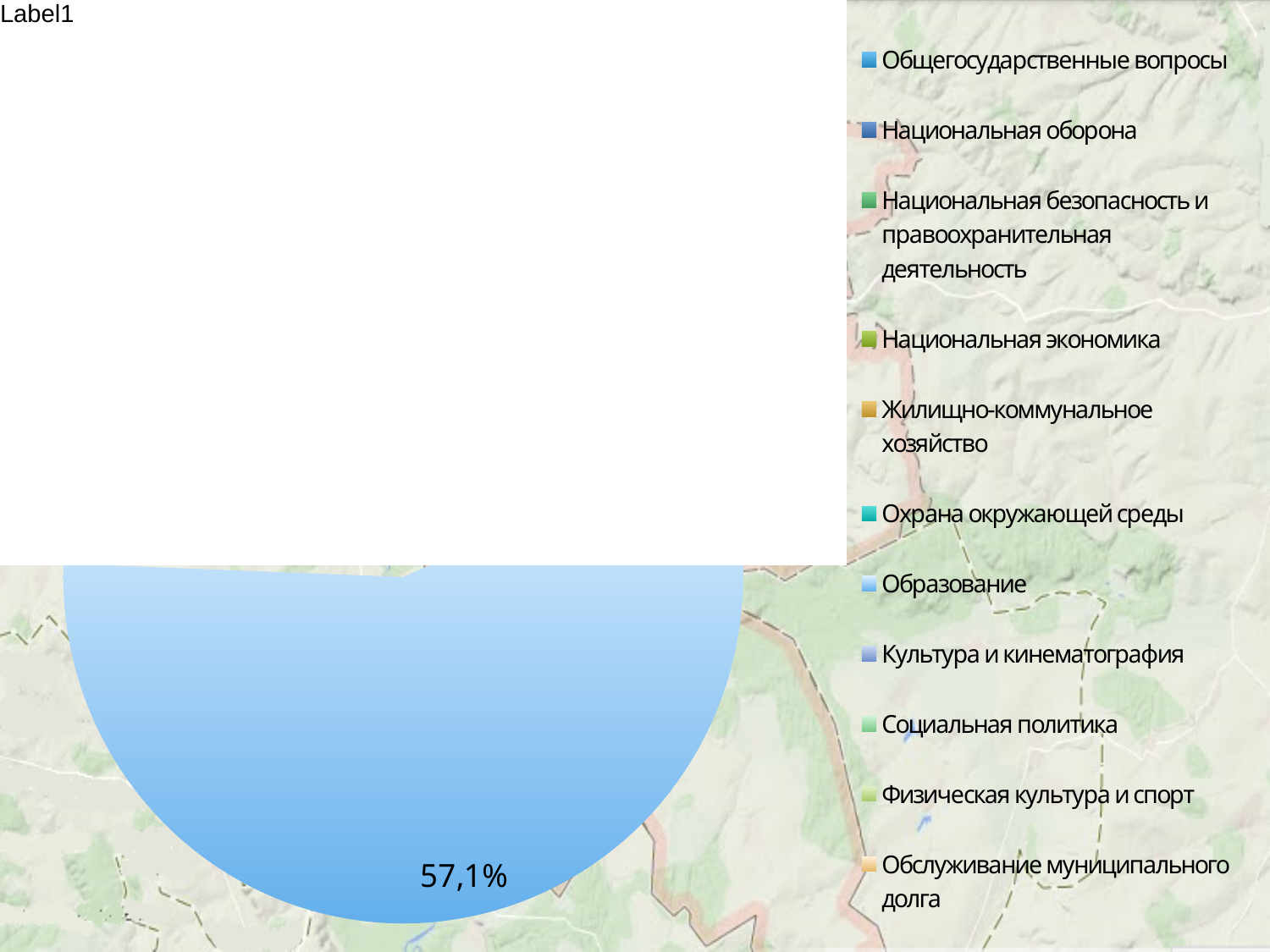
How many entries does the chart's legend list? 11 What kind of chart is shown on the slide? pie chart Which legend entry does the light-blue slice labelled 57,1% correspond to? Образование What value is printed on the large visible slice of the pie chart? 57,1% Which entry is listed first in the chart's legend? Общегосударственные вопросы What share of the pie does the slice labelled on the chart represent? 57,1% Is the share of the labelled slice greater or less than 50%? greater